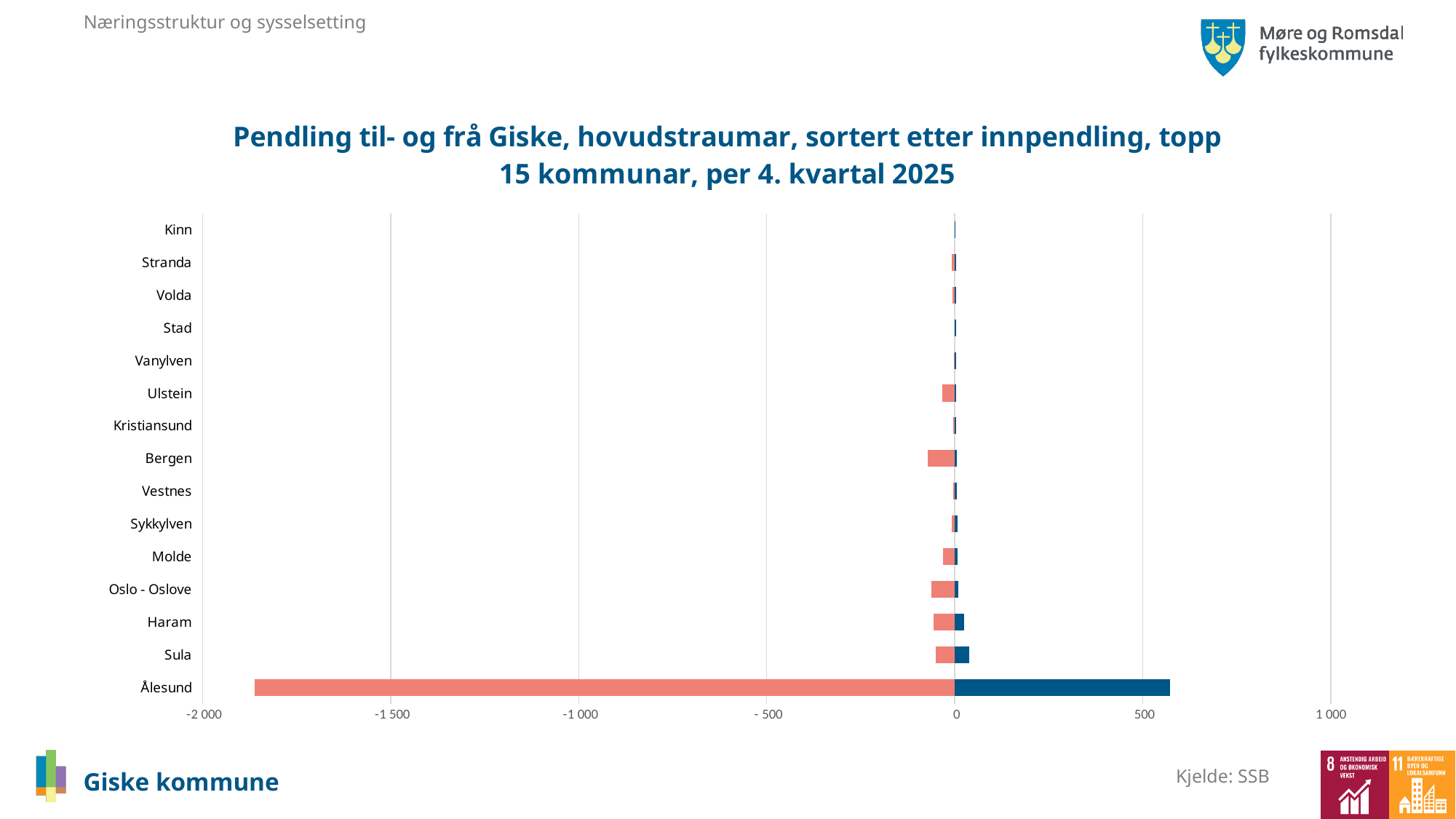
What kind of chart is shown on the slide? bar chart Which municipality has the longest bars in the chart? Ålesund Which has the longer negative (left-pointing) bar, Bergen or Ulstein? Bergen Which municipality is listed at the top of the vertical axis? Kinn Is the negative (left-pointing) bar for Ålesund less than -1 500 or greater than -1 500? less Is the positive (right-pointing) bar for Sula greater or less than 500? less Which has the longer positive (right-pointing) bar, Ålesund or Sula? Ålesund Is the positive (right-pointing) bar for Ålesund greater or less than 500? greater What is the lowest value shown on the horizontal axis? -2 000 How many municipalities (categories) are listed on the vertical axis of the chart? 15